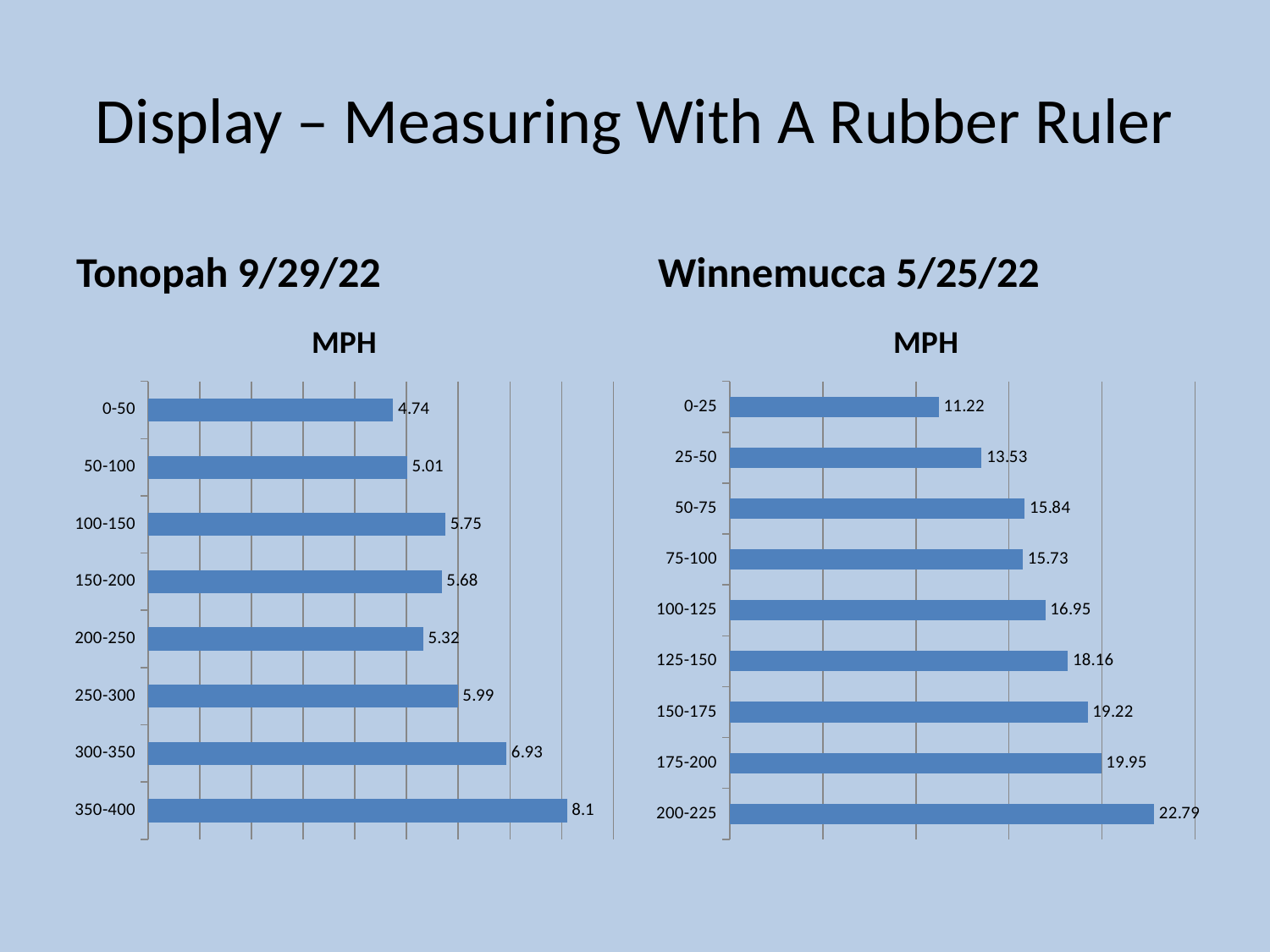
How many categories are shown in the Winnemucca 5/25/22 chart? 9 How many categories are shown in the Tonopah 9/29/22 chart? 8 In the Winnemucca 5/25/22 chart, what is the difference between the values for 200-225 and 175-200? 2.84 In the Tonopah 9/29/22 chart, what is the value for the 350-400 category? 8.1 In the Tonopah 9/29/22 chart, which is larger, the value for 300-350 or the value for 250-300? 300-350 In the Tonopah 9/29/22 chart, which category has the lowest value? 0-50 In the Tonopah 9/29/22 chart, what is the value for the 200-250 category? 5.32 In the Tonopah 9/29/22 chart, what is the difference between the values for 350-400 and 0-50? 3.36 What type of chart is the Tonopah 9/29/22 chart? Bar chart In the Winnemucca 5/25/22 chart, which category has the highest value? 200-225 In the Winnemucca 5/25/22 chart, what is the value for the 100-125 category? 16.95 In the Winnemucca 5/25/22 chart, which category has the lowest value? 0-25